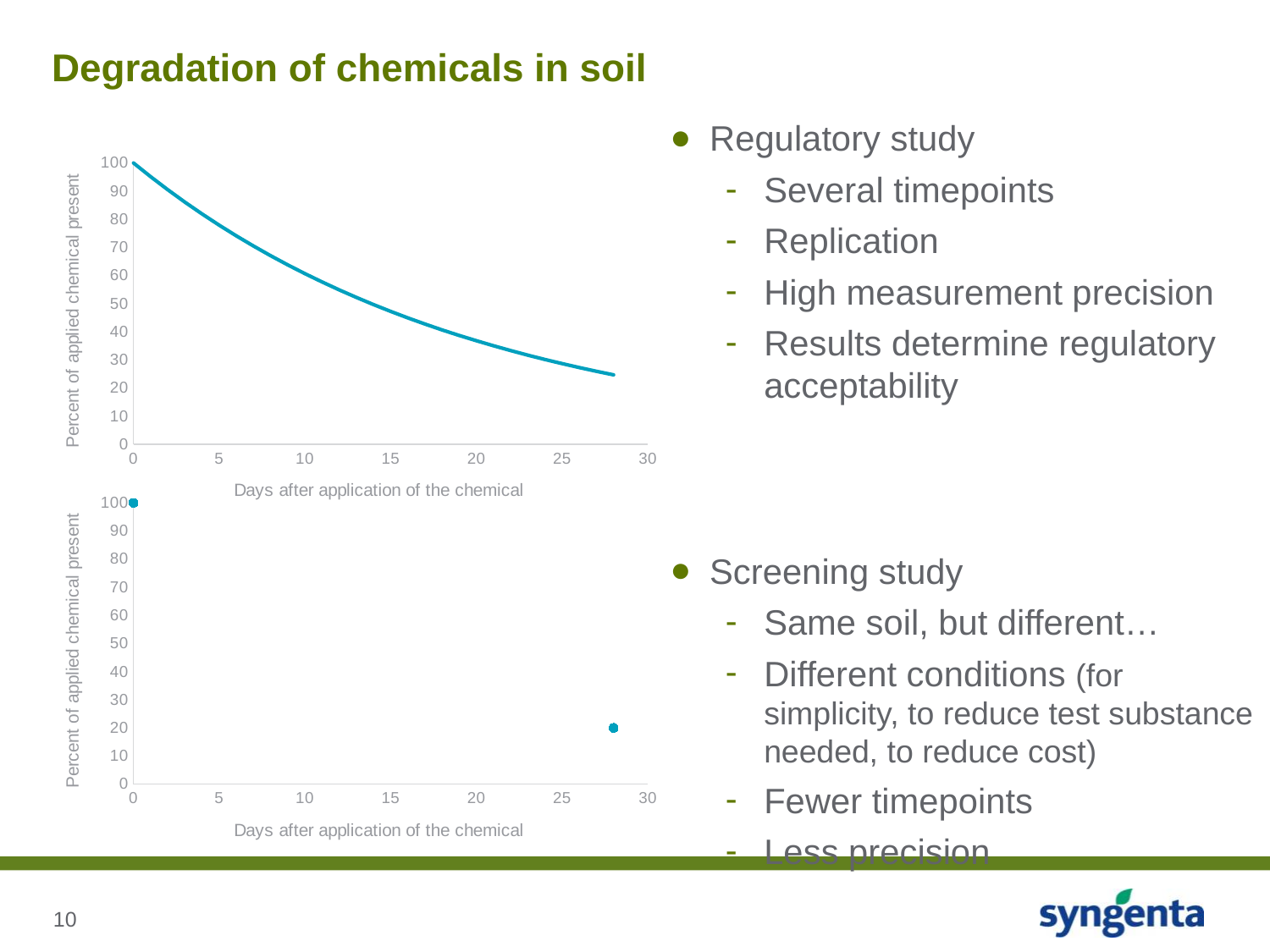
In the top chart, is the percent of applied chemical present at day 20 greater or less than 50? less What is the y-axis label of the bottom chart? Percent of applied chemical present In the top chart, does the percent of applied chemical present rise or fall as days after application increase? fall In the bottom chart, which data point has the higher value, the one at day 0 or the one near day 28? the one at day 0 In the bottom chart, what is the percent of applied chemical present at day 0? 100 In the top chart, what is the percent of applied chemical present at day 0? 100 What kind of chart is the top chart on the slide? line chart What is the x-axis label of the top chart? Days after application of the chemical In the bottom chart, is the value of the later data point (near day 28) greater or less than 30? less How many data points are plotted in the bottom chart? 2 What kind of chart is the bottom chart on the slide? scatter chart In the top chart, is the percent of applied chemical present at day 10 greater or less than 50? greater